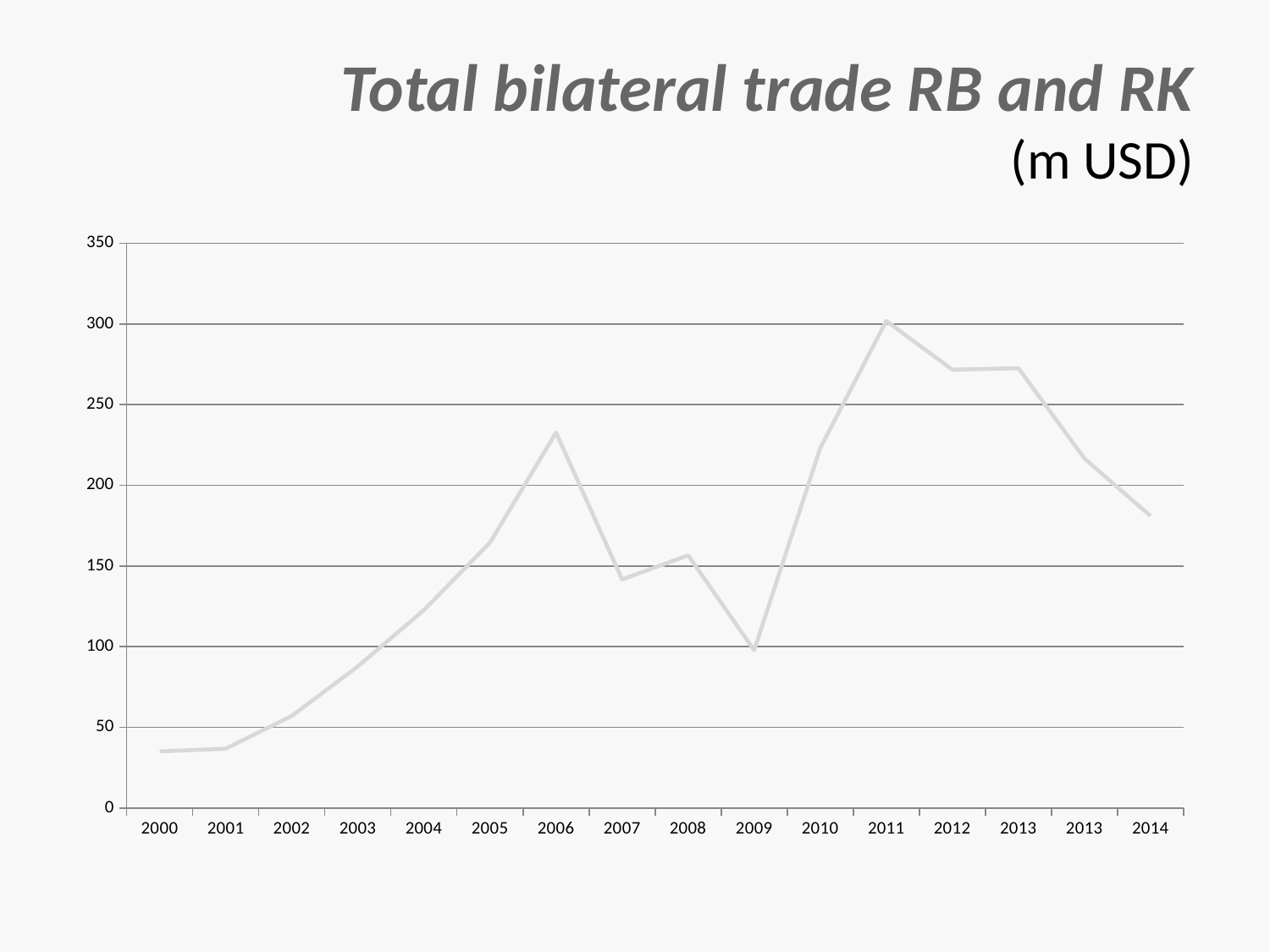
In what unit are the values on the chart expressed? m USD Is the value for 2014 greater or less than 200? less Which year has the larger value, 2006 or 2008? 2006 Do the values rise or fall from 2000 to 2006? rise Is the value for 2006 greater or less than 200? greater In which year does the line reach its highest value? 2011 Is the value for 2012 greater or less than 250? greater What is the title of the chart? Total bilateral trade RB and RK What kind of chart is shown on the slide? line chart Which year has the larger value, 2011 or 2013? 2011 How many data points are plotted along the x axis? 16